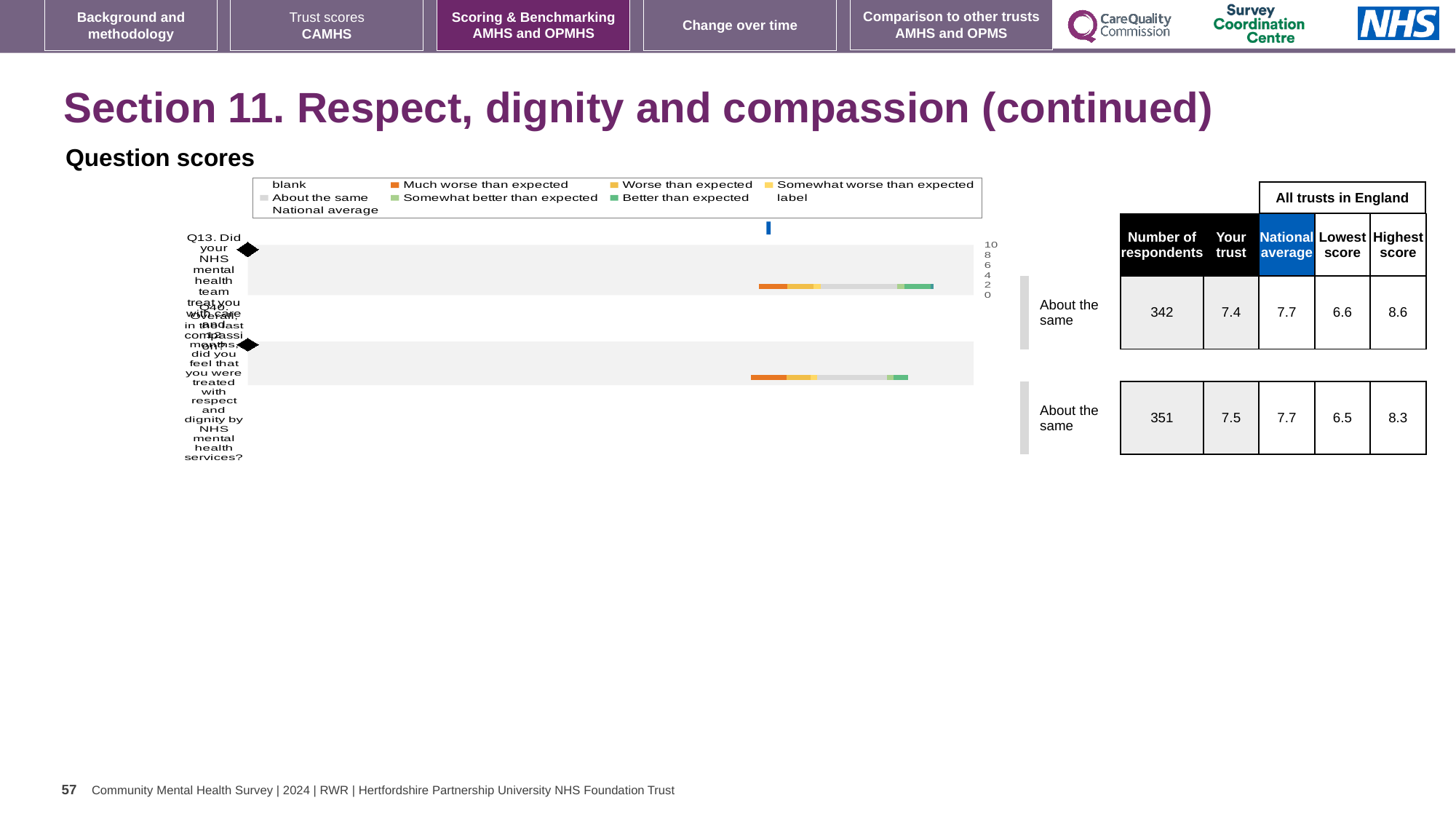
What is the highest score across all trusts in England for Q13? 8.6 What kind of chart is used to show the question scores? Bar chart What benchmark category is shown next to the Q13 bar? About the same Which question row has more respondents, the first (Q13) or the second (Q10)? The second (Q10) What is the lowest score across all trusts in England for the second question row (Q10)? 6.5 What is the 'Your trust' score for the second question row (Q10)? 7.5 What is the difference between the highest score and the lowest score for Q13? 2.0 What is the 'Your trust' score for Q13? 7.4 How many question rows are plotted in the chart? 2 By how much is the national average higher than the 'Your trust' score for Q13? 0.3 What is the national average score for Q13? 7.7 How many respondents are shown for Q13 (Did your NHS mental health team treat you with care and compassion?)? 342